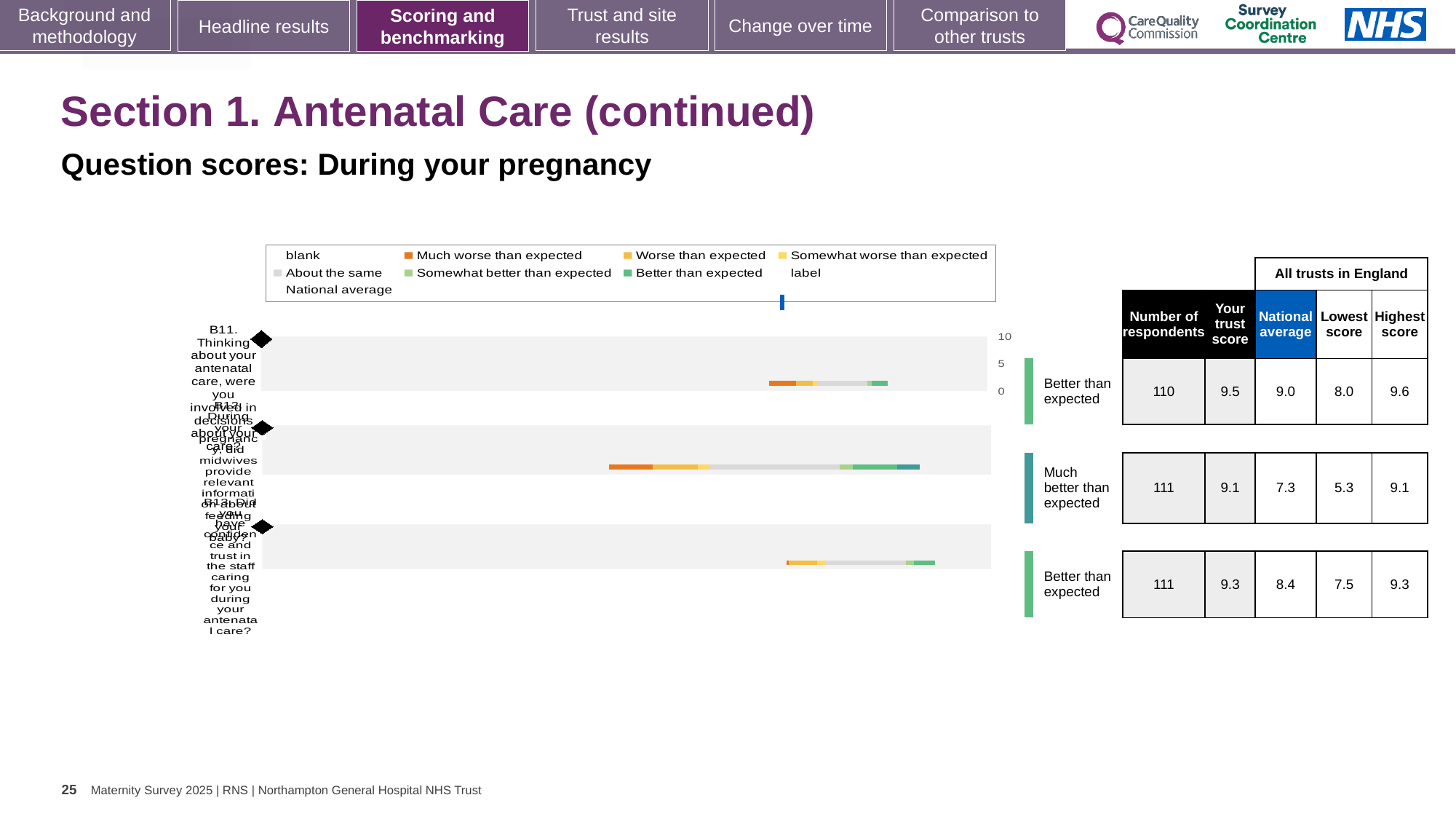
In the chart legend, what colour represents 'Much worse than expected'? orange What benchmark category is shown for question B12? Much better than expected What kind of chart is shown on the slide? bar chart Which has the larger trust score, B11 or B13? B11 In the table next to the chart, what is the trust score for question B12? 9.1 In the table next to the chart, what is the national average for question B13? 8.4 In the table next to the chart, how many respondents answered question B11? 110 Which question has the lowest national average in the table? B12 How many survey questions (rows) are plotted in the chart? 3 By how much does the trust score for B12 exceed its national average? 1.8 Which question has the highest 'Your trust score' in the table? B11